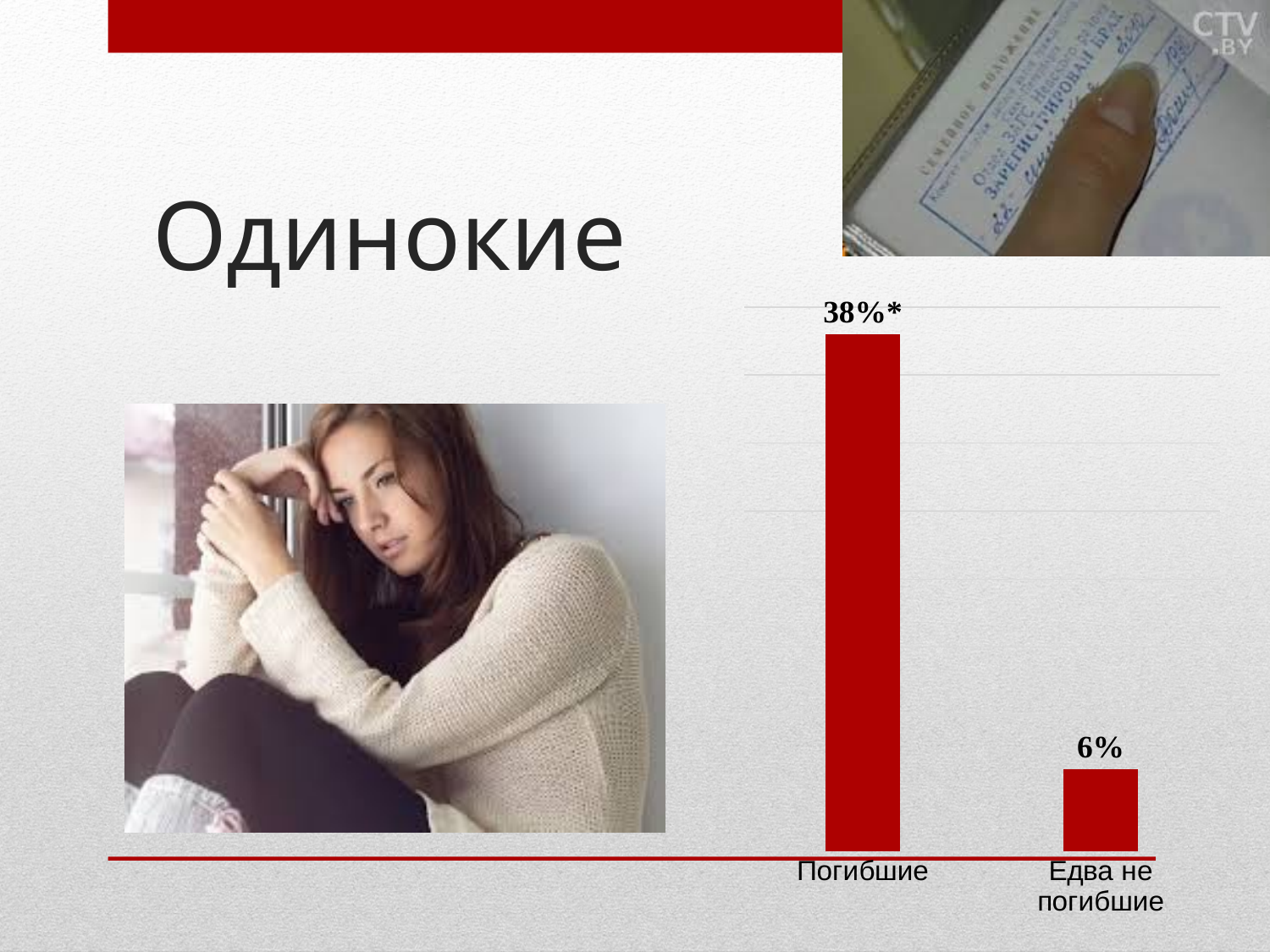
Which is larger, the value for Погибшие or the value for Едва не погибшие? Погибшие Which category has the highest value? Погибшие What is the value shown for Едва не погибшие? 6% What colour are the bars in the chart? Red What kind of chart is shown on the slide? Bar chart What is the title text on the slide? Одинокие What is the difference between the values for Погибшие and Едва не погибшие? 32% Which category has the lowest value? Едва не погибшие What is the value shown for Погибшие? 38%* How many categories are shown in the chart? 2